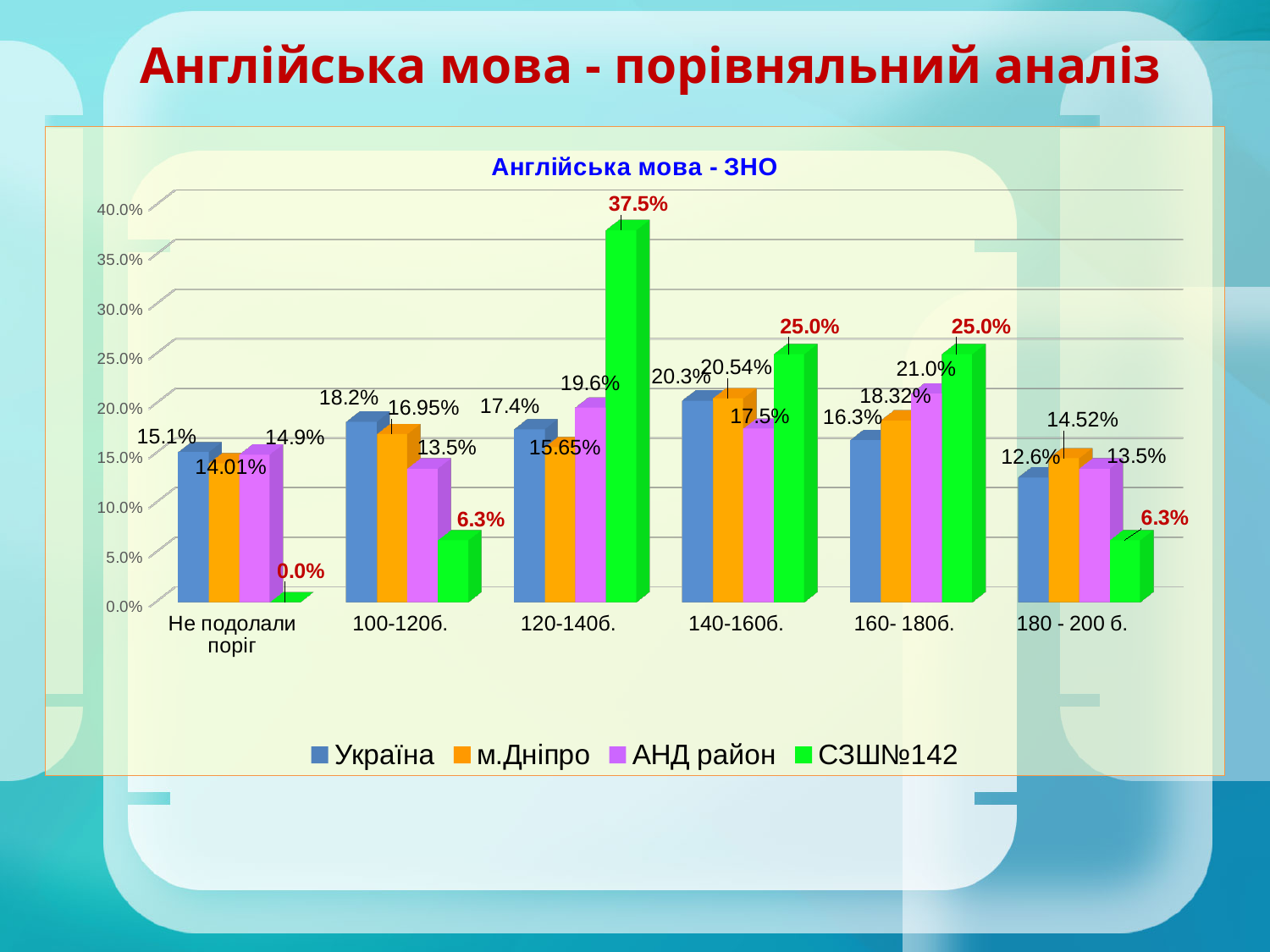
In the 180 - 200 б. category, which is larger: the value for м.Дніпро or the value for СЗШ№142? м.Дніпро Which category has the lowest value for СЗШ№142? Не подолали поріг What is the value for Україна in the 'Не подолали поріг' category? 15.1% Which category has the highest value for СЗШ№142? 120-140б. What is the title of the chart? Англійська мова - ЗНО What kind of chart is shown on the slide? Bar chart How many categories are shown on the x axis? 6 What is the value for АНД район in the 140-160б. category? 17.5% What is the value for СЗШ№142 in the 120-140б. category? 37.5% How many series does the legend list? 4 What is the difference between the СЗШ№142 value and the Україна value in the 120-140б. category? 20.1% What is the value for м.Дніпро in the 160- 180б. category? 18.32%